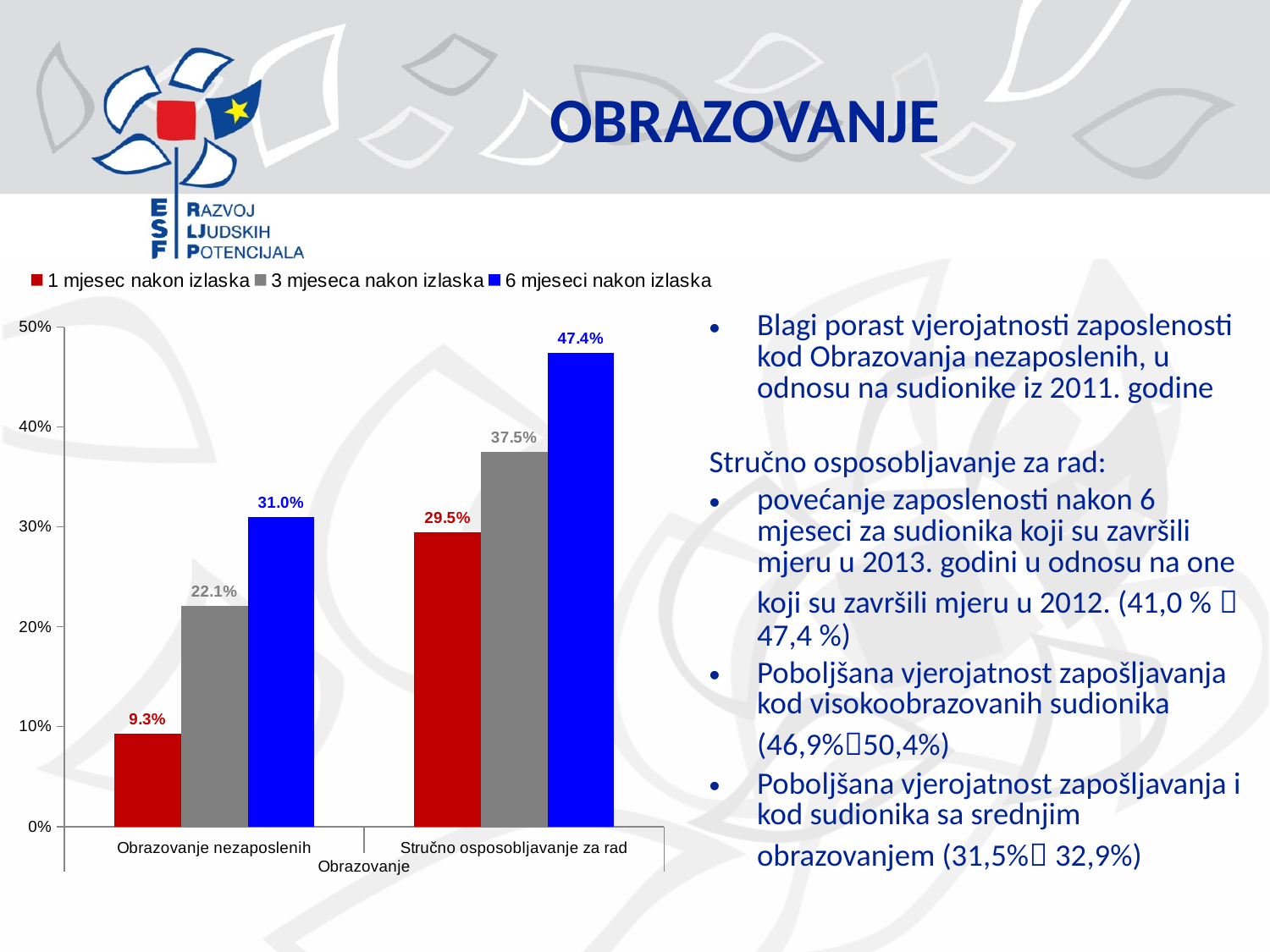
What is the value for '1 mjesec nakon izlaska' in the 'Obrazovanje nezaposlenih' category? 9.3% What is the value for '6 mjeseci nakon izlaska' in the 'Stručno osposobljavanje za rad' category? 47.4% What is the difference between the '3 mjeseca nakon izlaska' and '1 mjesec nakon izlaska' values in the 'Obrazovanje nezaposlenih' category? 12.8% Which bar has the highest value on the chart? 6 mjeseci nakon izlaska, Stručno osposobljavanje za rad Which bar has the lowest value on the chart? 1 mjesec nakon izlaska, Obrazovanje nezaposlenih How many series does the chart legend list? 3 What kind of chart is shown on the slide? Bar chart What is the value for '3 mjeseca nakon izlaska' in the 'Stručno osposobljavanje za rad' category? 37.5% How many categories are shown on the x axis of the chart? 2 What is the difference between the '6 mjeseci nakon izlaska' values for 'Stručno osposobljavanje za rad' and 'Obrazovanje nezaposlenih'? 16.4% Which is larger: the '1 mjesec nakon izlaska' value for 'Stručno osposobljavanje za rad' or the '3 mjeseca nakon izlaska' value for 'Obrazovanje nezaposlenih'? Stručno osposobljavanje za rad (29.5%) Within each category, do the values rise or fall from '1 mjesec nakon izlaska' to '6 mjeseci nakon izlaska'? Rise